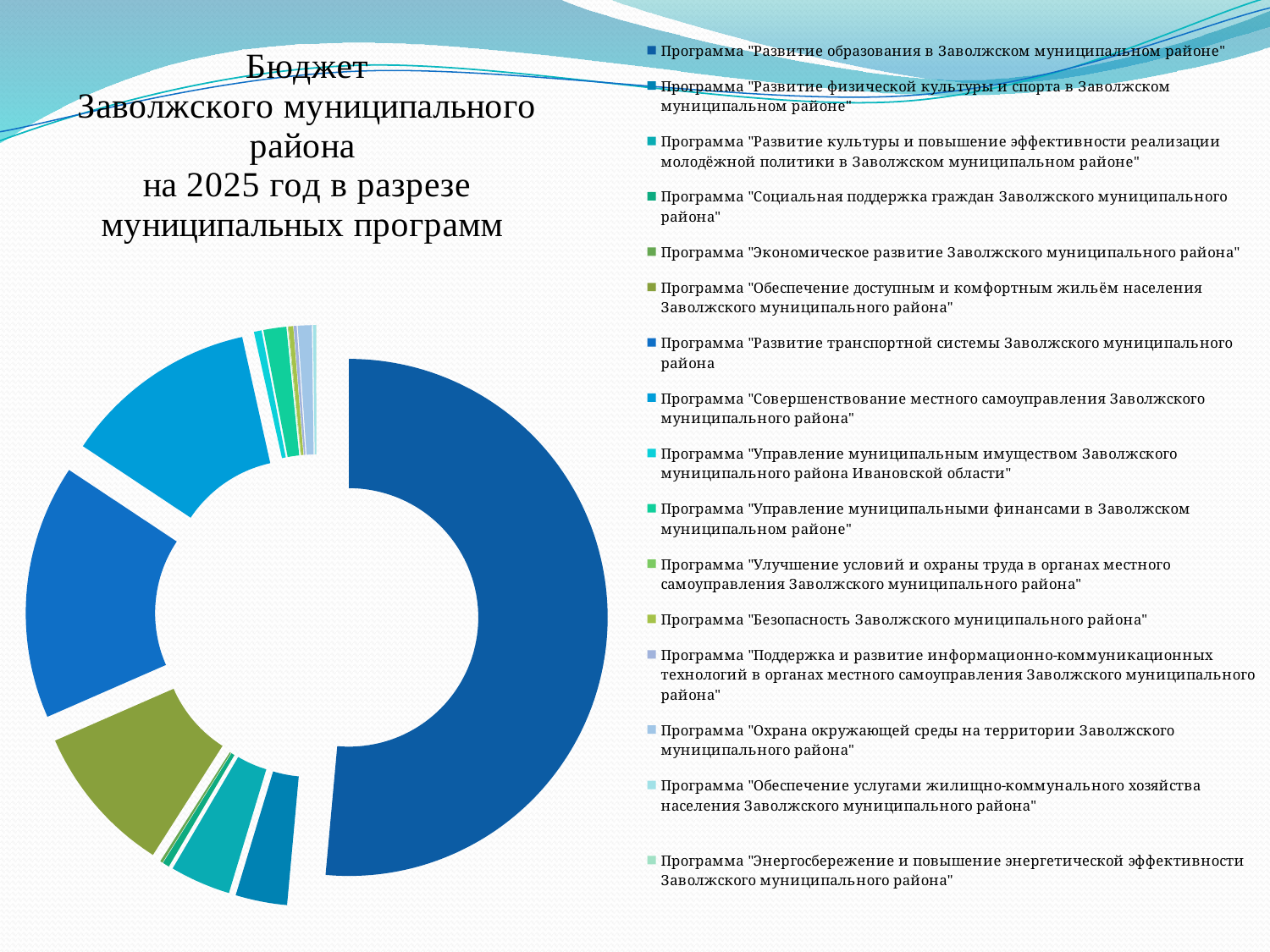
Which program has the largest share of the 2025 budget in the chart? Программа "Развитие образования в Заволжском муниципальном районе" How many municipal programs are listed in the chart's legend? 16 Which is larger: the share for the program "Развитие образования в Заволжском муниципальном районе" or the share for the program "Развитие транспортной системы Заволжского муниципального района"? Программа "Развитие образования в Заволжском муниципальном районе" Which program is listed first in the chart's legend? Программа "Развитие образования в Заволжском муниципальном районе" For which year does the chart show the budget of the Zavolzhsky municipal district? 2025 What kind of chart is shown on the slide? Doughnut (pie) chart Which is larger: the share for the program "Развитие физической культуры и спорта в Заволжском муниципальном районе" or the share for the program "Энергосбережение и повышение энергетической эффективности Заволжского муниципального района"? Программа "Развитие физической культуры и спорта в Заволжском муниципальном районе" What is the title of the chart on the slide? Бюджет Заволжского муниципального района на 2025 год в разрезе муниципальных программ